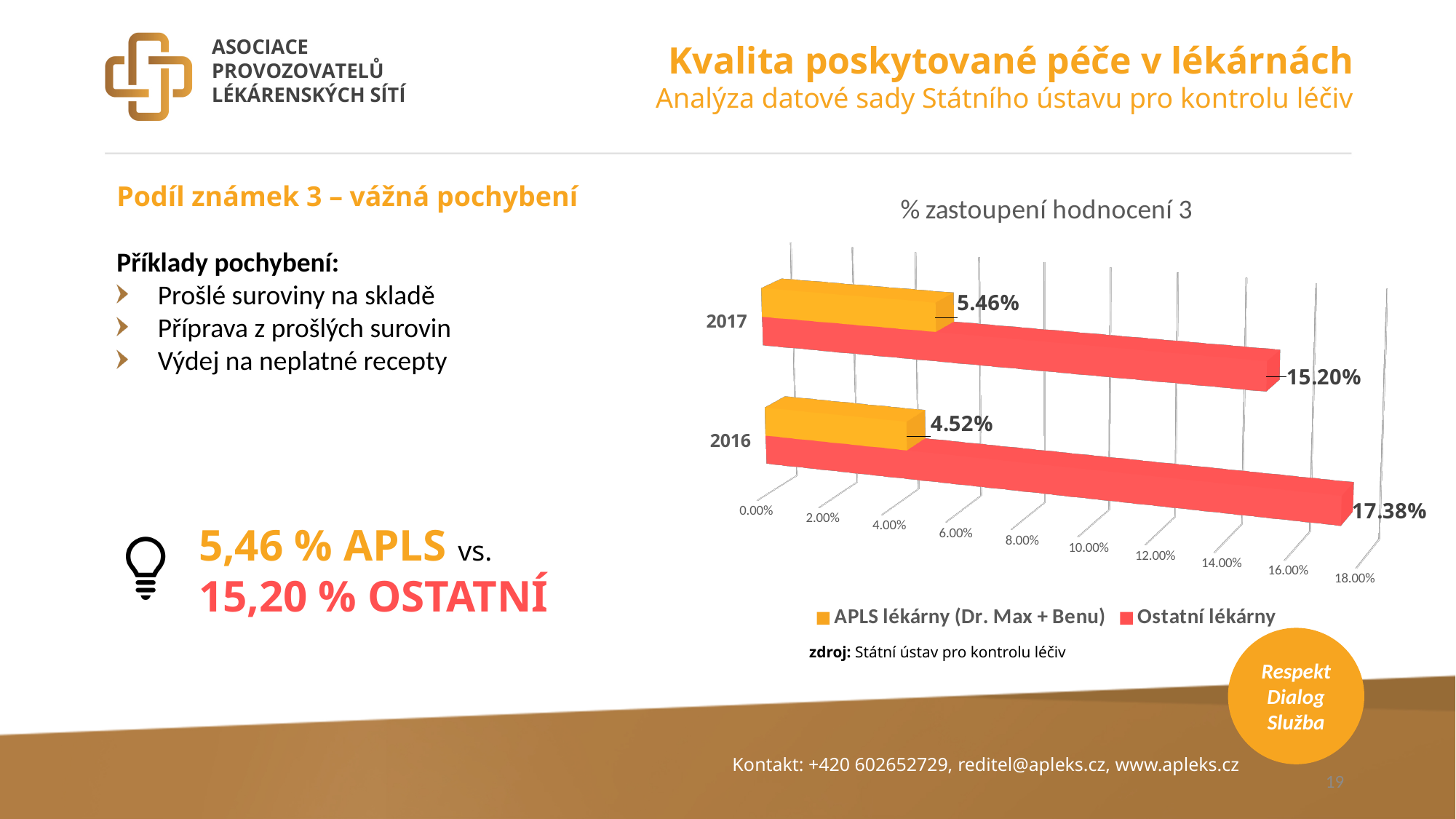
How many series does the chart legend list? 2 Which is larger in 2016: APLS lékárny (Dr. Max + Benu) or Ostatní lékárny? Ostatní lékárny What is the title of the chart? % zastoupení hodnocení 3 What is the difference between Ostatní lékárny and APLS lékárny (Dr. Max + Benu) in 2017? 9.74 percentage points How many years (categories) are shown in the chart? 2 What is the value for Ostatní lékárny in 2017? 15.20% Did the value for Ostatní lékárny rise or fall from 2016 to 2017? fall What is the value for APLS lékárny (Dr. Max + Benu) in 2017? 5.46% What is the value for APLS lékárny (Dr. Max + Benu) in 2016? 4.52% What is the value for Ostatní lékárny in 2016? 17.38% What type of chart is shown on the slide? bar chart Which series has the highest value in the chart, and in which year? Ostatní lékárny, 2016